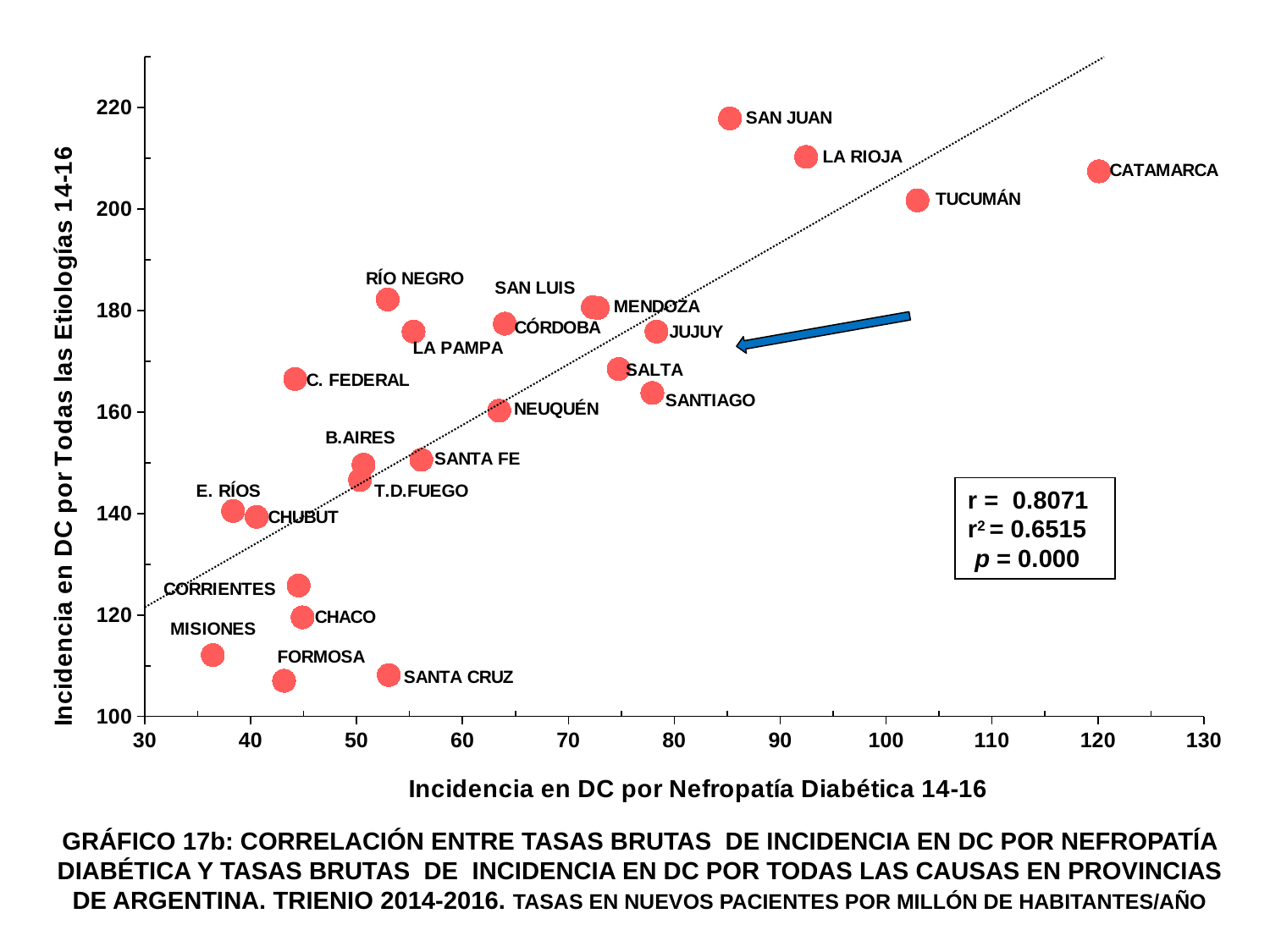
What kind of chart is shown on the slide? Scatter chart What correlation coefficient r is shown in the box on the chart? 0.8071 Which province has the highest incidence in DC por nefropatía diabética (x axis)? Catamarca Do the y-axis values generally rise or fall as the x-axis value increases? Rise How many provinces are plotted as points on the chart? 24 Which province has the highest incidence in DC por todas las etiologías (y axis)? San Juan Which has a higher y-axis value, Corrientes or Chaco? Corrientes Is the y-axis value for C. Federal greater or less than 160? greater Is the y-axis value for Misiones greater or less than 120? less Is the x-axis value for La Rioja greater or less than 90? greater Which has a higher y-axis value, San Juan or La Rioja? San Juan